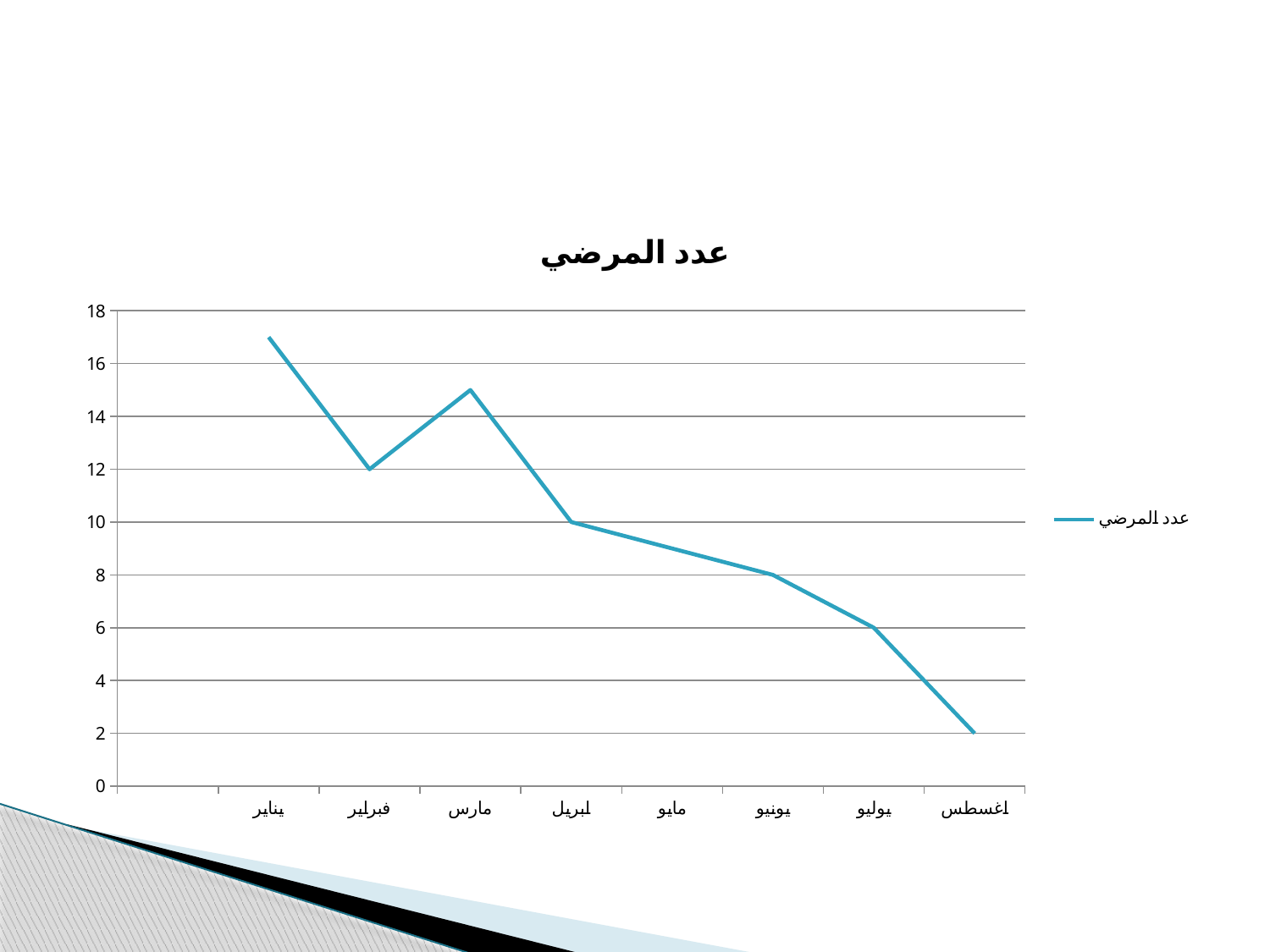
What is the value for ابريل? 10 What kind of chart is shown on the slide? line chart How many series does the legend list? 1 Which month has the lowest number of patients? اغسطس Is the value for يناير greater or less than 16? greater What is the difference between the values for يونيو and يوليو? 2 How many months are plotted on the x axis? 8 What is the value for اغسطس? 2 Which month has the highest number of patients? يناير What is the value for فبراير? 12 What is the title of the chart? عدد المرضي Do the values generally rise or fall from يناير to اغسطس? fall